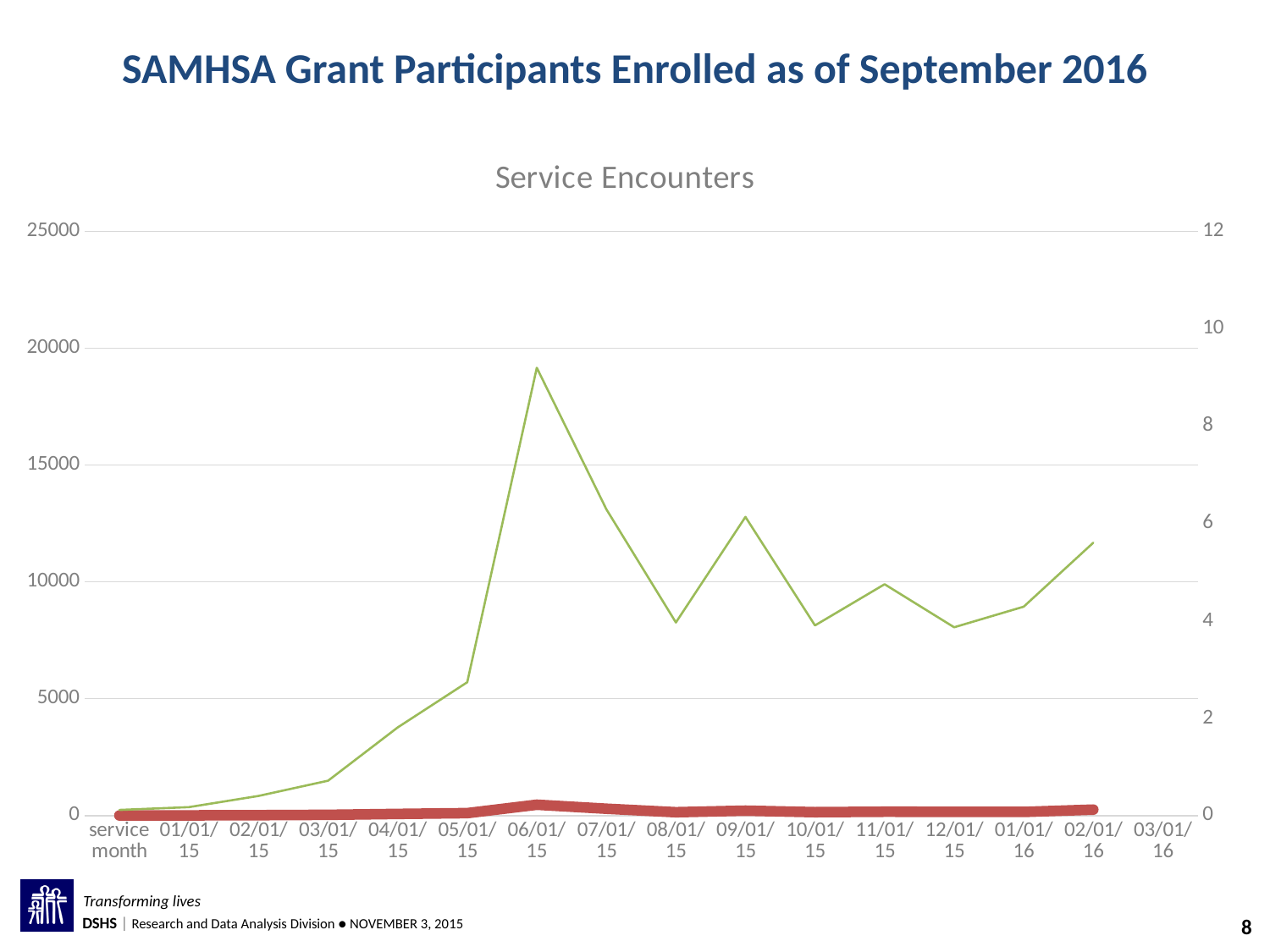
Which month has the larger value on the green line, 06/01/15 or 09/01/15? 06/01/15 Is the value of the green line at 03/01/15 greater or less than 5000? less Is the value of the green line at 02/01/16 greater or less than 10000? greater Is the value of the green line at 08/01/15 greater or less than 10000? less At which month does the green line reach its highest value? 06/01/15 How many lines are plotted on the chart? 2 Which month has the larger value on the green line, 09/01/15 or 11/01/15? 09/01/15 What kind of chart is shown on the slide? line chart Does the green line rise or fall from 01/01/15 to 06/01/15? rises What is the title of the chart? Service Encounters